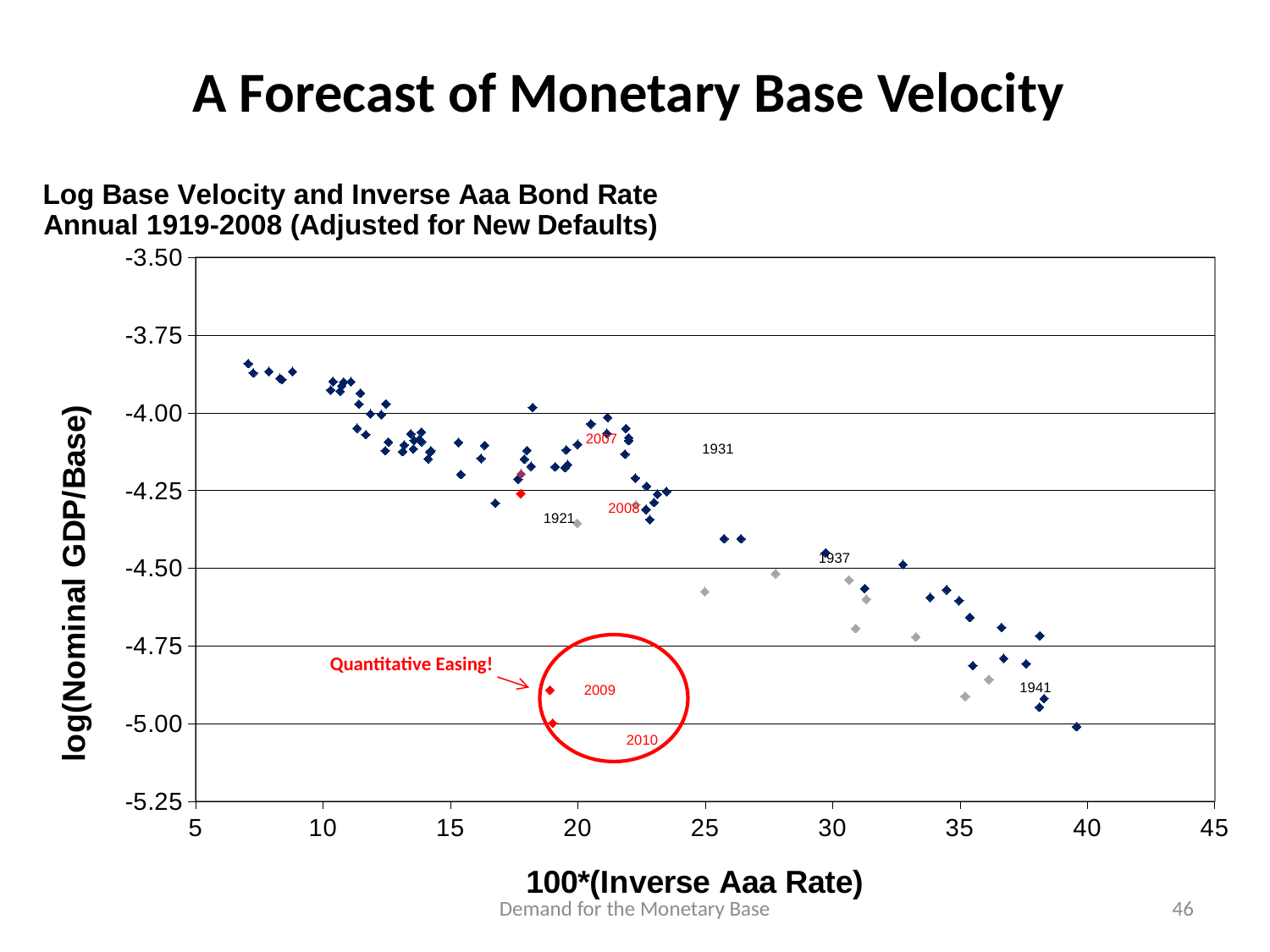
Is the log(Nominal GDP/Base) value for the 1941 point greater or less than -4.75? less What kind of chart is shown on the slide? scatter chart What annotation text points to the circled 2009 and 2010 points? Quantitative Easing! What is the title of the chart? Log Base Velocity and Inverse Aaa Bond Rate Annual 1919-2008 (Adjusted for New Defaults) Is the 100*(Inverse Aaa Rate) value for the 1937 point greater or less than 25? greater How many points on the chart are labeled with a year? 8 As 100*(Inverse Aaa Rate) increases along the x axis, do the log(Nominal GDP/Base) values generally rise or fall? fall Is the log(Nominal GDP/Base) value for the 2007 point greater or less than -4.25? greater